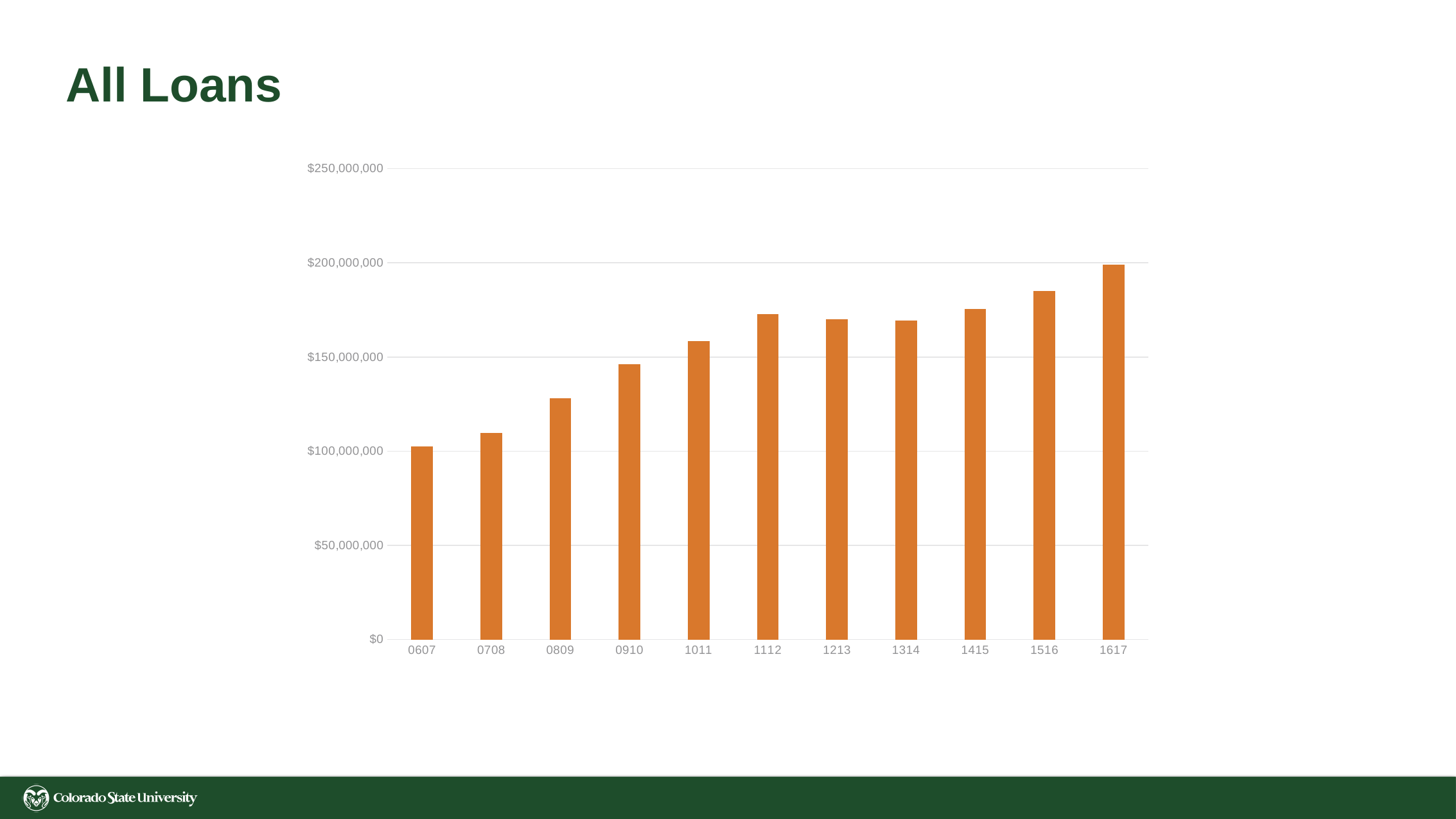
Which is larger, the value for 1617 or the value for 0607? 1617 How many years (bars) are plotted in the All Loans chart? 11 Which is larger, the value for 1516 or the value for 1314? 1516 Which year has the lowest loan total in the All Loans chart? 0607 Do the loan totals generally rise or fall from 0607 to 1617? Rise Is the value for 0809 greater or less than $150,000,000? less What kind of chart is shown on the slide? Bar chart What is the title of the slide containing the chart? All Loans Is the value for 1112 greater or less than $150,000,000? greater Which year has the highest loan total in the All Loans chart? 1617 Is the value for 0708 greater or less than $100,000,000? greater